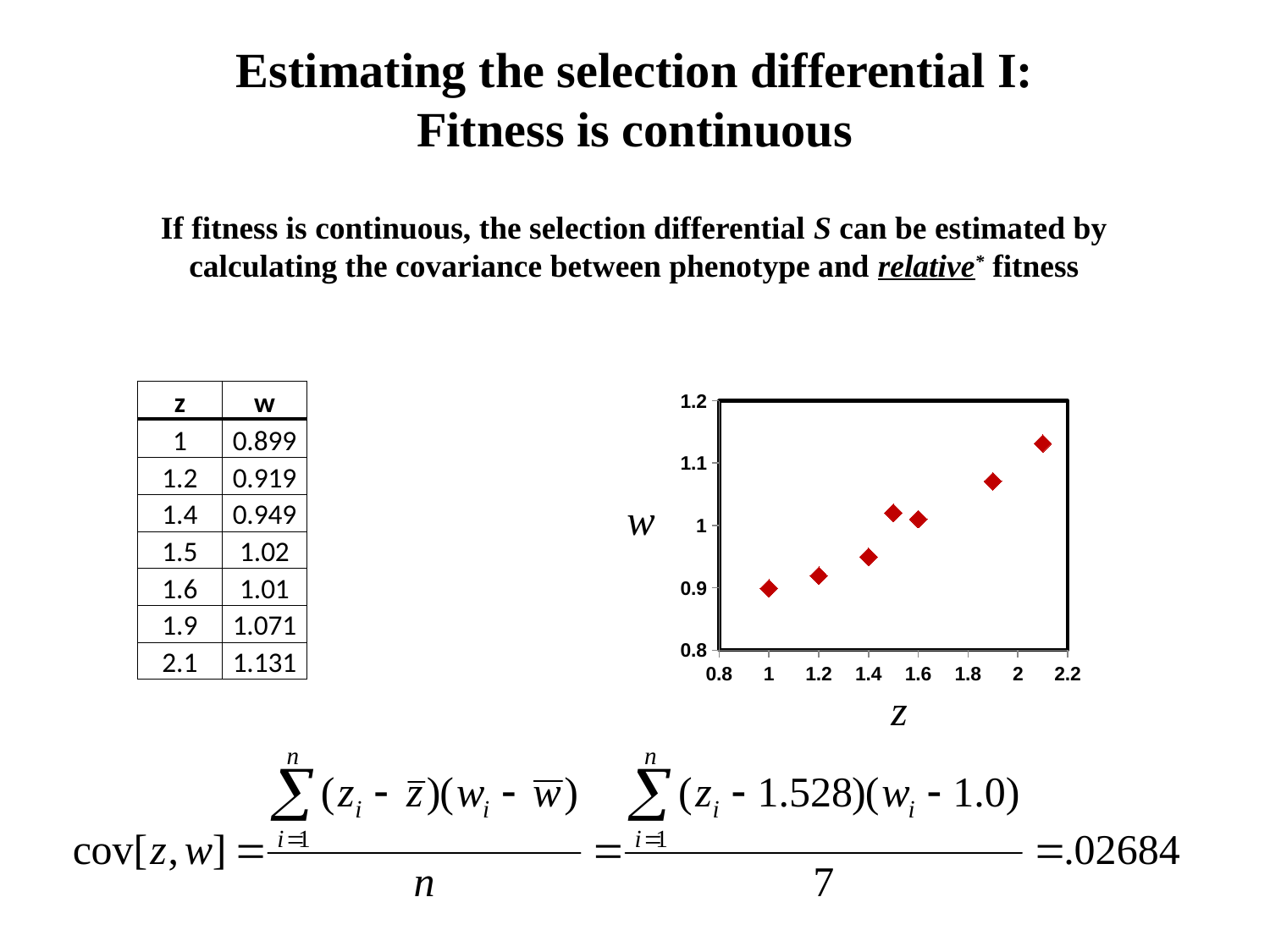
Which z value has the lowest w in the chart? 1 Is the w value for z = 2.1 greater or less than 1.1? greater What is the label on the y axis of the chart? w Which z value has the highest w in the chart? 2.1 What kind of chart is shown on the slide? scatter chart Do the w values generally rise or fall as z increases along the x axis? rise According to the table, what is the w value for z = 1.5? 1.02 What is the label on the x axis of the chart? z According to the table, what is the w value for z = 2.1? 1.131 Is the w value for z = 1.9 greater or less than 1? greater Is the w value for z = 1.4 greater or less than 1? less How many data points are plotted in the scatter chart? 7